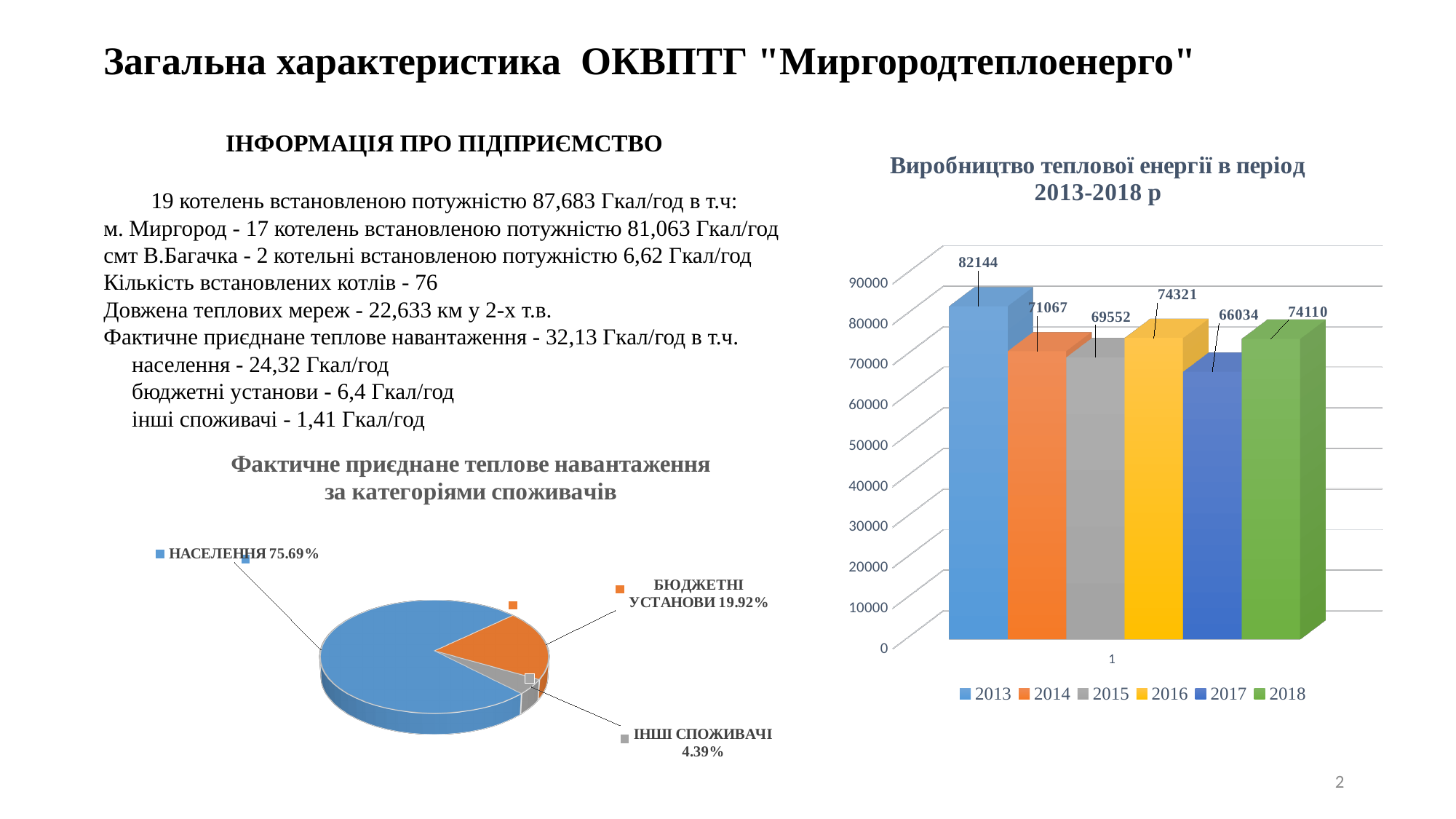
In the chart 'Виробництво теплової енергії в період 2013-2018 р', what is the value for 2017? 66034 In the pie chart 'Фактичне приєднане теплове навантаження за категоріями споживачів', how many slices are there? 3 In the chart 'Виробництво теплової енергії в період 2013-2018 р', which year has the highest value? 2013 In the pie chart 'Фактичне приєднане теплове навантаження за категоріями споживачів', which category has the largest slice? НАСЕЛЕННЯ In the chart 'Виробництво теплової енергії в період 2013-2018 р', what is the difference between the values for 2013 and 2014? 11077 In the pie chart 'Фактичне приєднане теплове навантаження за категоріями споживачів', what share does НАСЕЛЕННЯ have? 75.69% In the chart 'Виробництво теплової енергії в період 2013-2018 р', which year has the lowest value? 2017 In the pie chart 'Фактичне приєднане теплове навантаження за категоріями споживачів', what share does ІНШІ СПОЖИВАЧІ have? 4.39% In the chart 'Виробництво теплової енергії в період 2013-2018 р', how many series does the legend list? 6 In the chart 'Виробництво теплової енергії в період 2013-2018 р', what is the value for 2013? 82144 In the chart 'Виробництво теплової енергії в період 2013-2018 р', which is larger, the value for 2016 or the value for 2018? 2016 What kind of chart is 'Виробництво теплової енергії в період 2013-2018 р'? Bar chart